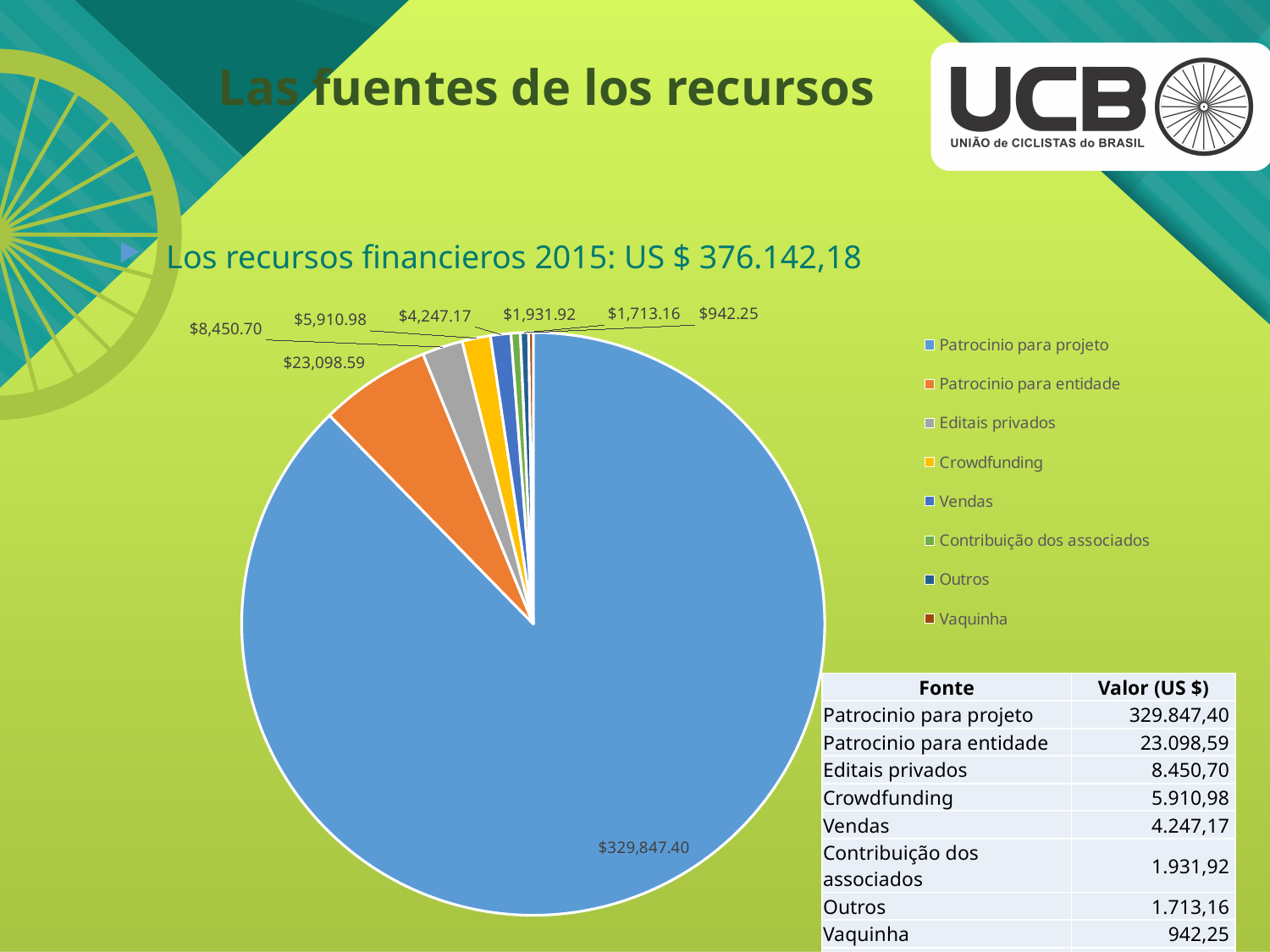
What is the value shown for Patrocinio para projeto in the pie chart? $329,847.40 How many slices does the pie chart have? 8 What colour is the slice for Patrocinio para entidade in the pie chart? orange What is the value shown for Crowdfunding in the pie chart? $5,910.98 Which is larger in the pie chart, Editais privados or Vendas? Editais privados How many entries does the legend of the pie chart list? 8 Which source has the largest slice in the pie chart? Patrocinio para projeto What is the value shown for Vaquinha in the pie chart? $942.25 Which source has the smallest slice in the pie chart? Vaquinha What kind of chart is shown on the slide? pie chart What is the difference between the values for Patrocinio para entidade and Editais privados in the pie chart? $14,647.89 What is the value shown for Patrocinio para entidade in the pie chart? $23,098.59